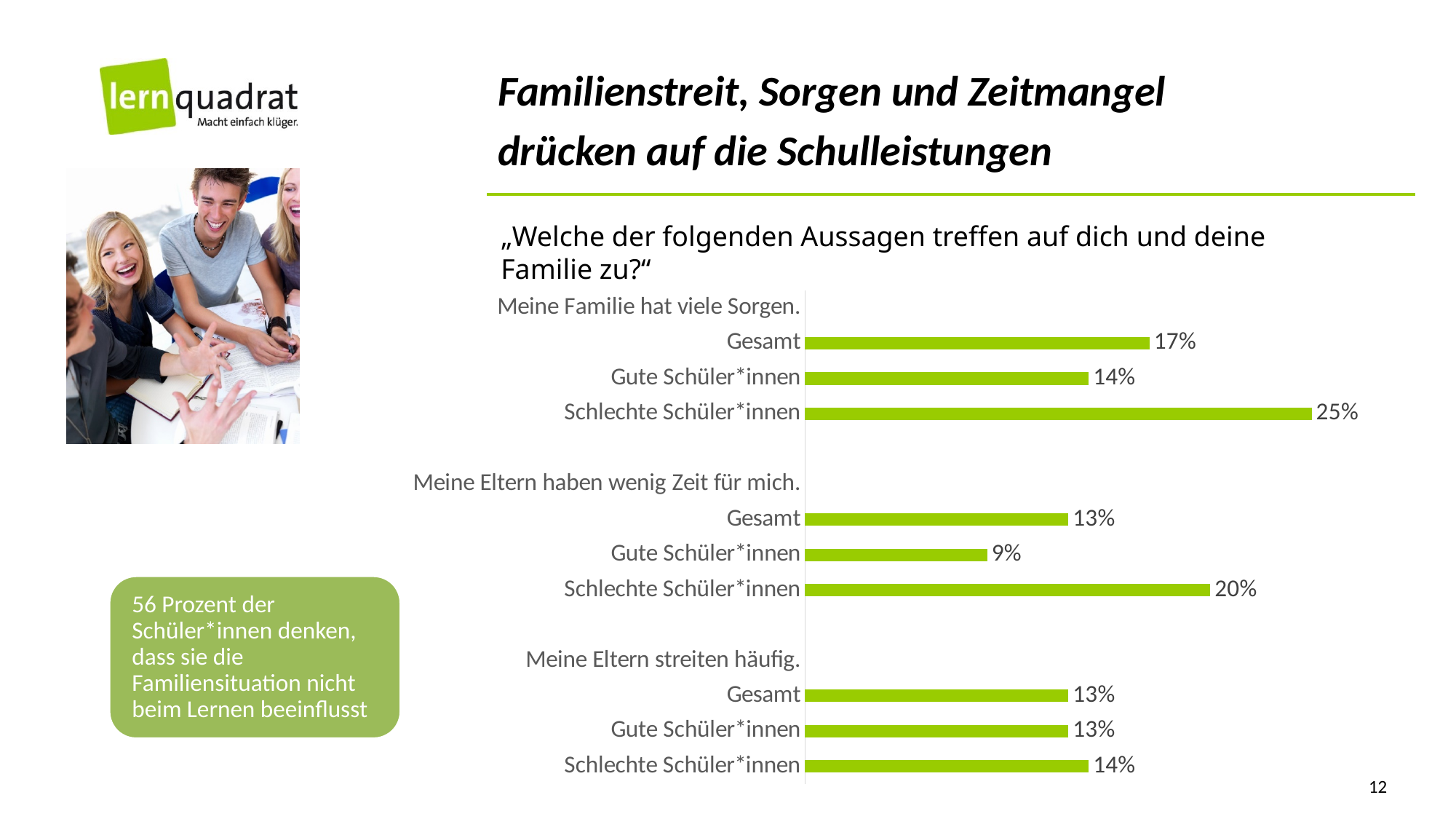
What is the value for Gute Schüler*innen under "Meine Eltern haben wenig Zeit für mich."? 9% Which bar in the chart has the lowest value? Gute Schüler*innen (Meine Eltern haben wenig Zeit für mich.) What is the difference between Schlechte Schüler*innen and Gute Schüler*innen under "Meine Familie hat viele Sorgen."? 11% What kind of chart is shown on the slide? Bar chart What is the Gesamt value under "Meine Familie hat viele Sorgen."? 17% Which bar in the chart has the highest value? Schlechte Schüler*innen (Meine Familie hat viele Sorgen.) How many bars are plotted in the chart? 9 What is the Gesamt value under "Meine Eltern streiten häufig."? 13% What is the difference between Schlechte Schüler*innen and Gesamt under "Meine Eltern haben wenig Zeit für mich."? 7% Under "Meine Eltern streiten häufig.", which is larger: Schlechte Schüler*innen or Gute Schüler*innen? Schlechte Schüler*innen What colour are the bars in the chart? Green What is the value for Schlechte Schüler*innen under "Meine Familie hat viele Sorgen."? 25%